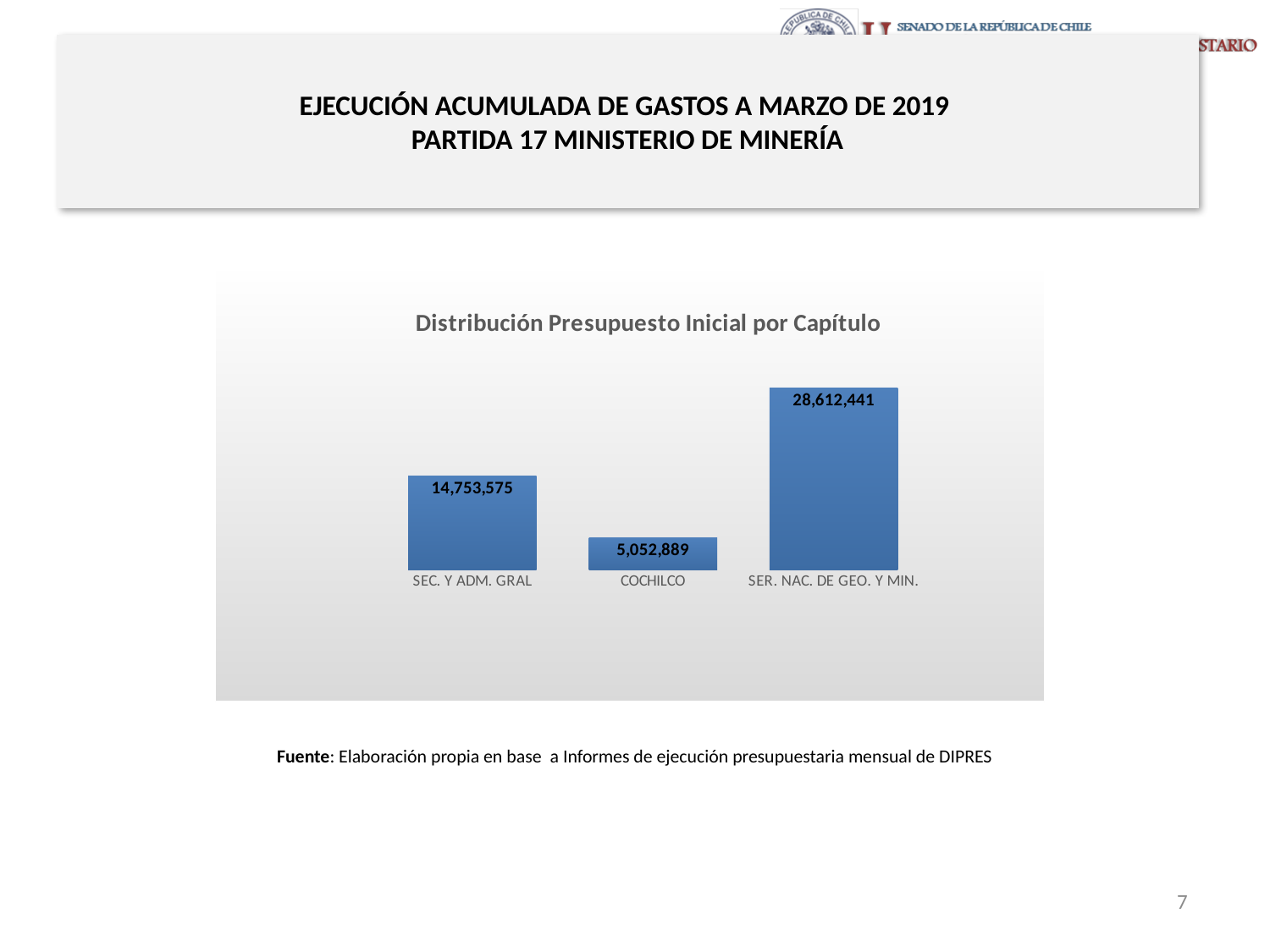
What is the title of the chart on the slide? Distribución Presupuesto Inicial por Capítulo What is the difference between the values for SER. NAC. DE GEO. Y MIN. and SEC. Y ADM. GRAL? 13,858,866 Which is larger, the value for SEC. Y ADM. GRAL or the value for COCHILCO? SEC. Y ADM. GRAL Which category has the lowest value in the chart? COCHILCO What is the value for SEC. Y ADM. GRAL in the chart? 14,753,575 What is the difference between the values for SEC. Y ADM. GRAL and COCHILCO? 9,700,686 What is the value for SER. NAC. DE GEO. Y MIN. in the chart? 28,612,441 Which category has the highest value in the chart? SER. NAC. DE GEO. Y MIN. What kind of chart is shown on the slide? Bar chart How many categories are shown in the chart? 3 What is the value for COCHILCO in the chart? 5,052,889 What is the difference between the values for SER. NAC. DE GEO. Y MIN. and COCHILCO? 23,559,552